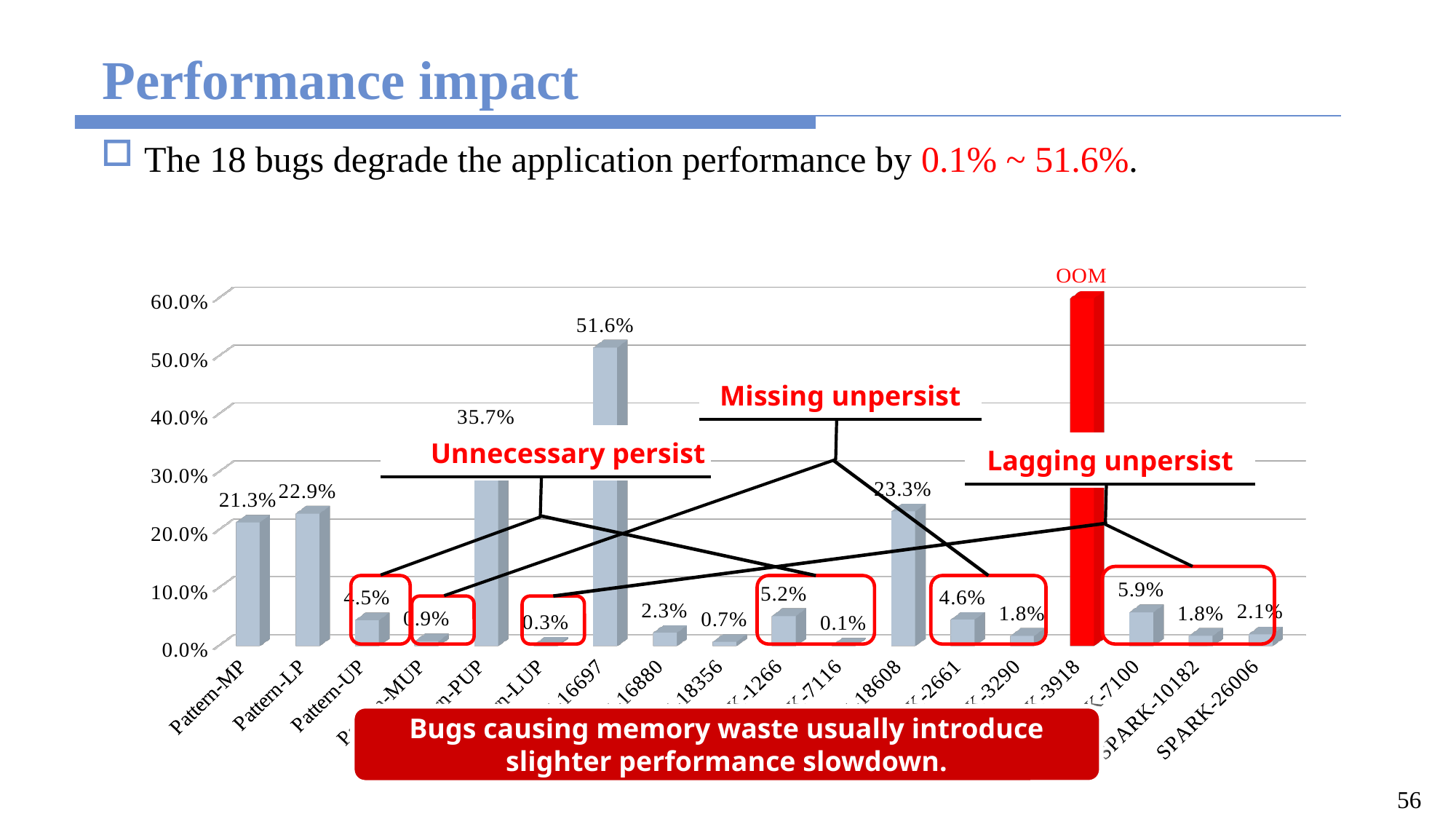
Which is larger, the value for Pattern-UP or the value for SPARK-26006? Pattern-UP What is the value for SPARK-10182? 1.8% Is the red bar labeled OOM greater or less than 50.0%? greater What is the value for Pattern-LP? 22.9% What kind of chart is shown on the slide? bar chart How many bars (categories) are plotted on the chart? 18 What is the difference between the values for Pattern-LP and Pattern-MP? 1.6% What is the difference between the values for SPARK-26006 and SPARK-10182? 0.3% What is the value for SPARK-26006? 2.1% What is the value for Pattern-UP? 4.5% What is the highest percentage data label printed on the chart? 51.6% What is the value for Pattern-MP? 21.3%